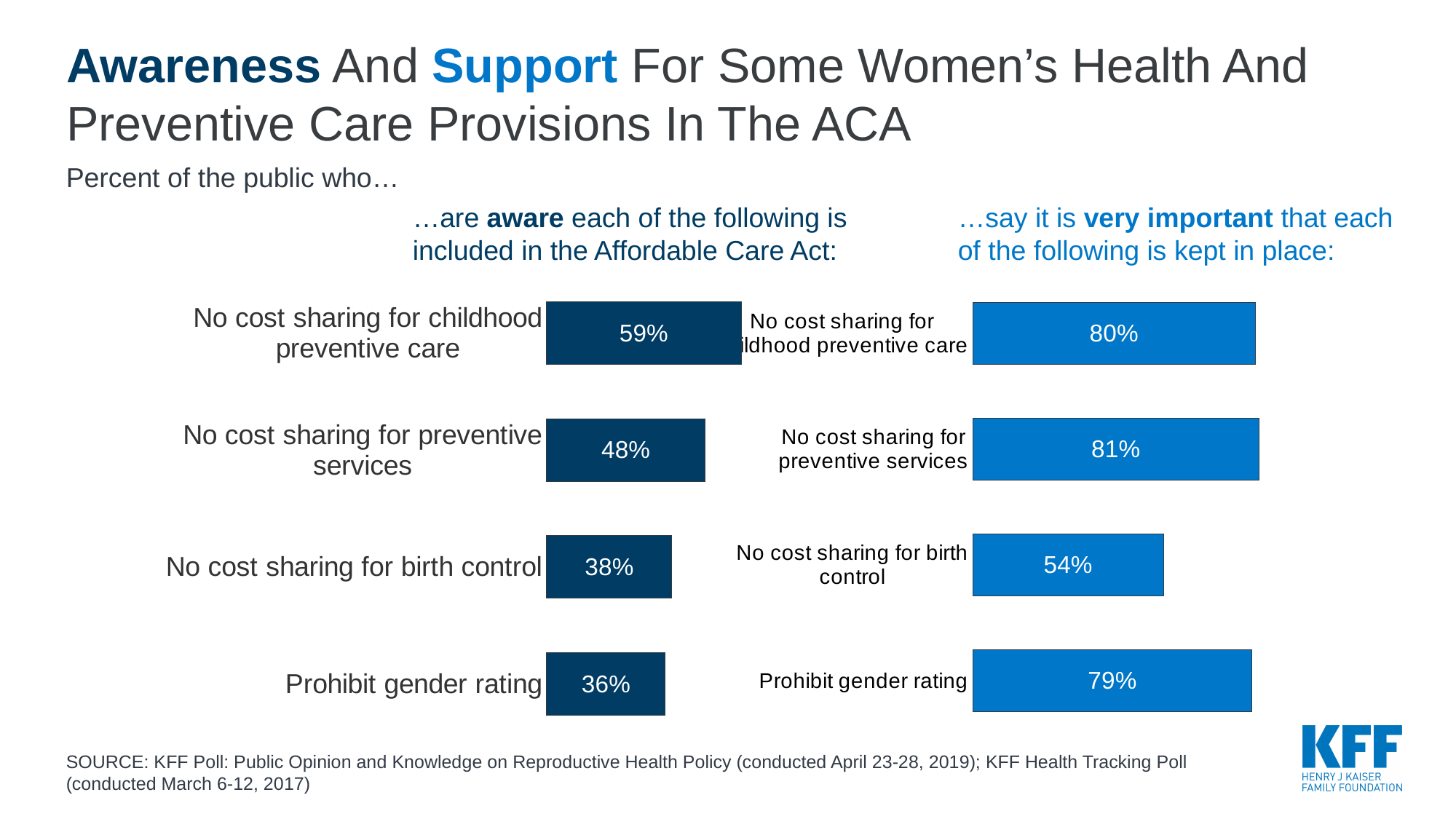
In the right chart (very important that each is kept in place), which provision has the lowest value? No cost sharing for birth control What kind of chart is used on this slide? Bar chart In the right chart (very important that each is kept in place), what percent say it is very important to keep no cost sharing for birth control? 54% In the left chart (aware each is included in the ACA), which provision has the lowest awareness? Prohibit gender rating What is the subtitle text shown below the slide title? Percent of the public who… In the right chart (very important that each is kept in place), what is the difference between the values for no cost sharing for preventive services and no cost sharing for birth control? 27 percentage points In the left chart (aware each is included in the ACA), which is larger: awareness of no cost sharing for birth control or of prohibit gender rating? No cost sharing for birth control In the right chart (very important that each is kept in place), what percent say it is very important to keep prohibit gender rating? 79% How many provisions are shown in the left chart (aware each is included in the ACA)? 4 In the left chart (aware each is included in the ACA), what is the difference between awareness of no cost sharing for childhood preventive care and no cost sharing for preventive services? 11 percentage points In the left chart (aware each is included in the ACA), which provision has the highest awareness? No cost sharing for childhood preventive care In the left chart (aware each is included in the ACA), what percent of the public are aware of no cost sharing for childhood preventive care? 59%